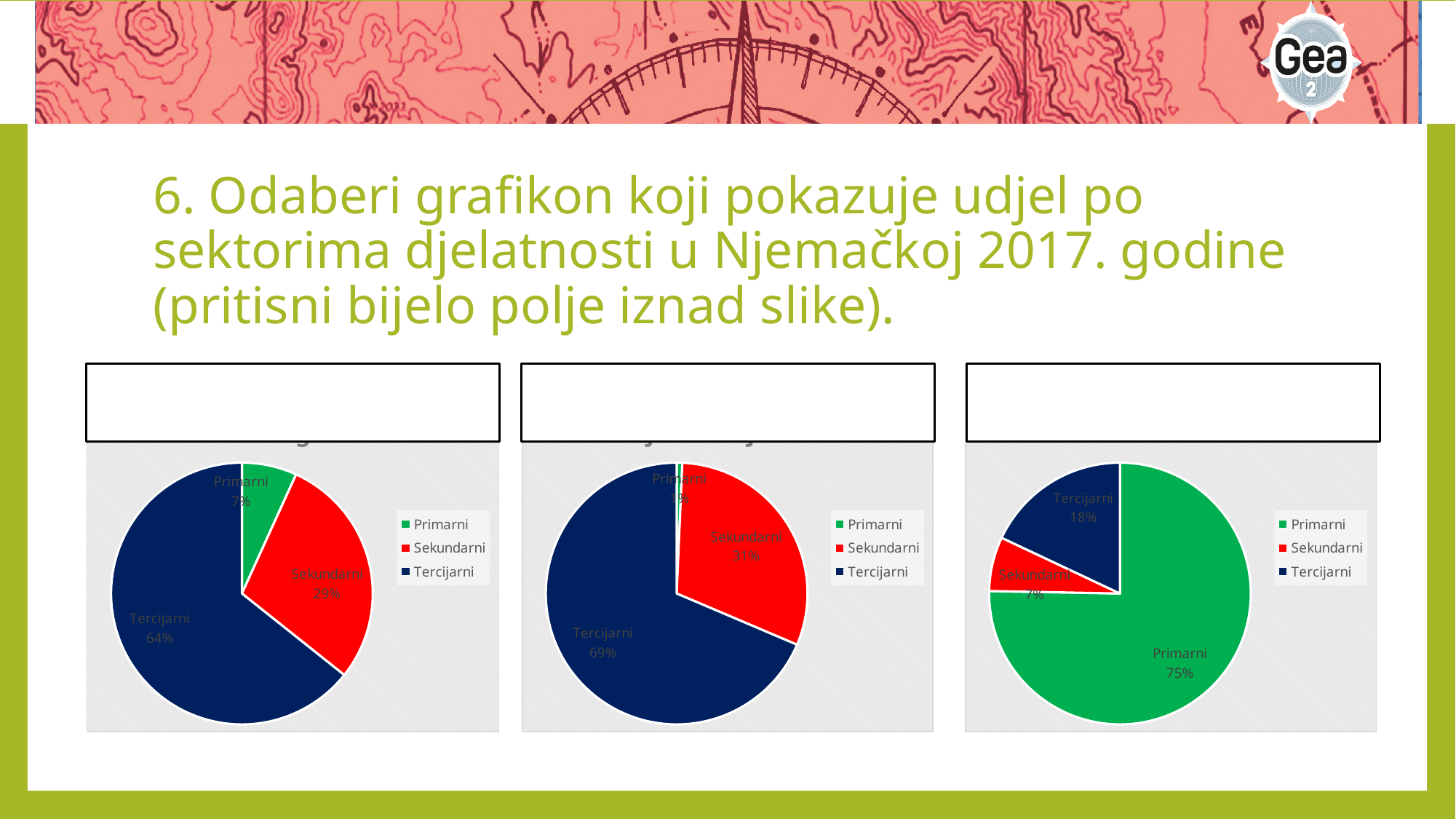
In the middle pie chart, which sector has the largest share? Tercijarni In the right pie chart, what share does Primarni have? 75% In the left pie chart, which sector has the smallest share? Primarni How many slices does the right pie chart have? 3 In the left pie chart, what share does Tercijarni have? 64% In the left pie chart, what is the difference between the Tercijarni and Sekundarni shares? 35% In the middle pie chart, what is the difference between the Tercijarni and Sekundarni shares? 38% In the right pie chart, what is the difference between the Primarni and Tercijarni shares? 57% In the right pie chart, which is larger, Sekundarni or Tercijarni? Tercijarni In the middle pie chart, what share does Sekundarni have? 31% In the left pie chart, what share does Sekundarni have? 29% What type of chart is the left chart? Pie chart